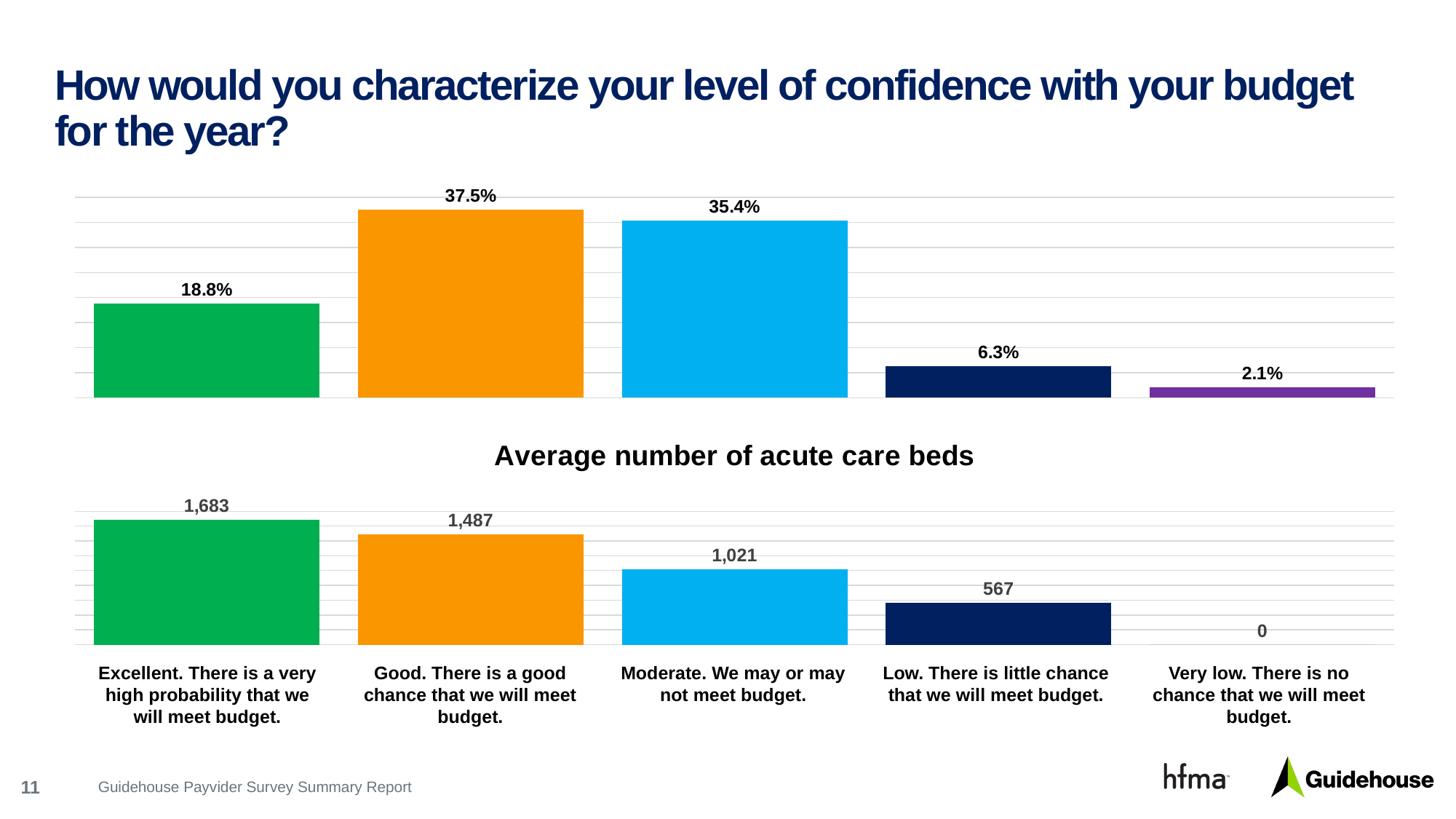
In the top chart, what is the difference in percentage points between the "Good" and "Moderate" categories? 2.1 What type of chart is the top chart on the slide? bar chart In the "Average number of acute care beds" chart, what is the difference between the values for "Excellent" and "Moderate"? 662 In the top chart, what percentage of respondents chose "Very low. There is no chance that we will meet budget."? 2.1% How many response categories are shown in the "Average number of acute care beds" chart? 5 In the "Average number of acute care beds" chart, do the values rise or fall moving from left to right across the categories? fall In the "Average number of acute care beds" chart, what is the value for "Low. There is little chance that we will meet budget."? 567 In the top chart, which is larger: the percentage for "Excellent" or the percentage for "Low"? Excellent In the top chart, which response category has the highest percentage? Good. There is a good chance that we will meet budget. In the "Average number of acute care beds" chart, which category has the lowest value? Very low. There is no chance that we will meet budget. In the "Average number of acute care beds" chart, what is the value for "Excellent. There is a very high probability that we will meet budget."? 1,683 In the top chart, what percentage of respondents chose "Good. There is a good chance that we will meet budget."? 37.5%